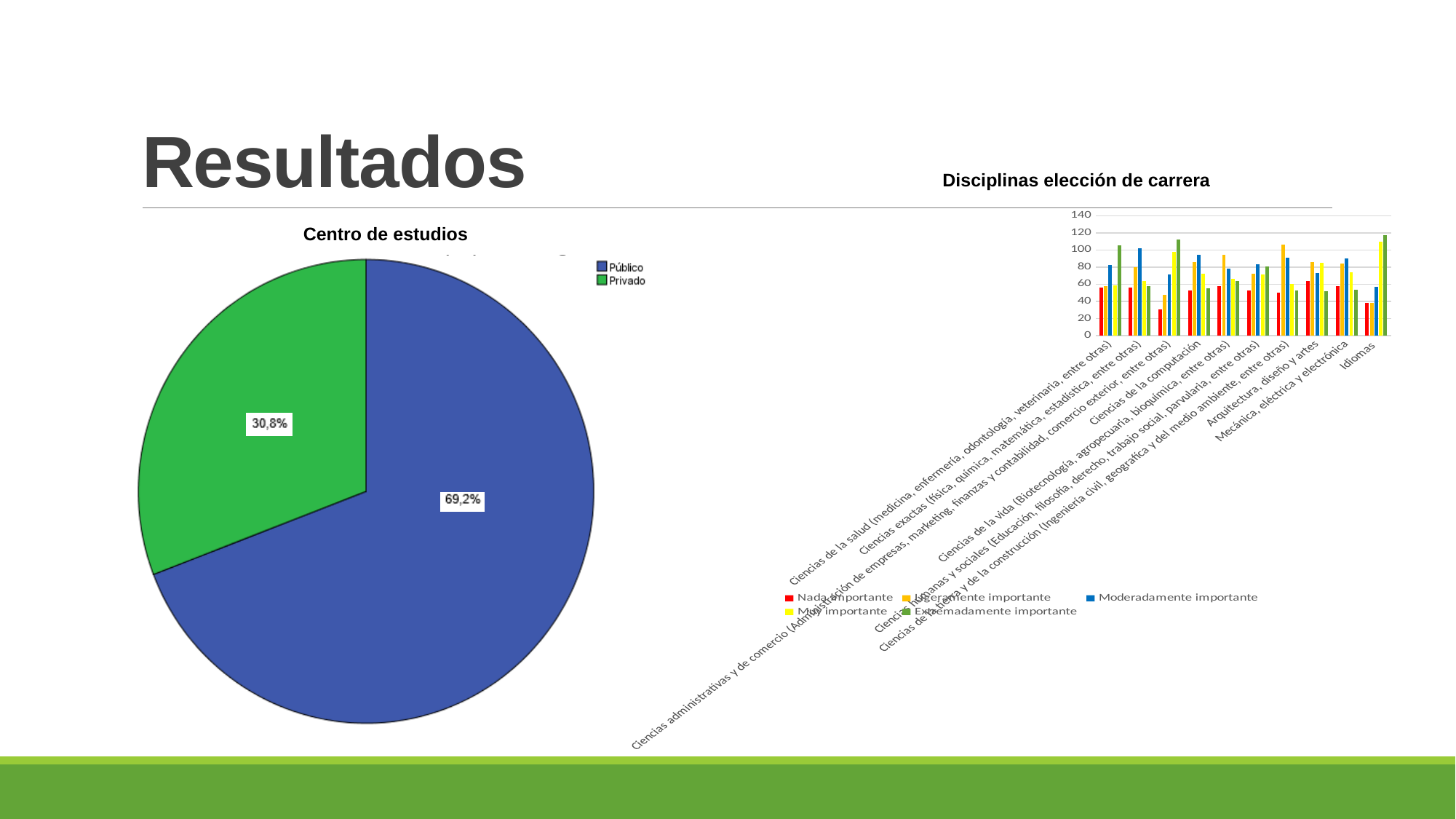
What kind of chart is 'Disciplinas elección de carrera'? Bar chart What kind of chart is 'Centro de estudios'? Pie chart In the 'Centro de estudios' pie chart, how many percentage points larger is Público than Privado? 38,4 In the 'Centro de estudios' pie chart, which slice is larger, Público or Privado? Público How many slices does the 'Centro de estudios' pie chart have? 2 In the 'Disciplinas elección de carrera' chart, is the value for 'Extremadamente importante' for Idiomas greater or less than 100? greater In the 'Centro de estudios' pie chart, what percentage is shown for Público? 69,2% In the 'Centro de estudios' pie chart, what percentage is shown for Privado? 30,8% In the 'Disciplinas elección de carrera' chart, is the value for 'Nada importante' for Ciencias administrativas y de comercio greater or less than 40? less In the 'Disciplinas elección de carrera' chart, which colour represents the 'Nada importante' series? Red How many categories are shown on the x axis of the 'Disciplinas elección de carrera' chart? 10 How many series does the legend of the 'Disciplinas elección de carrera' chart list? 5